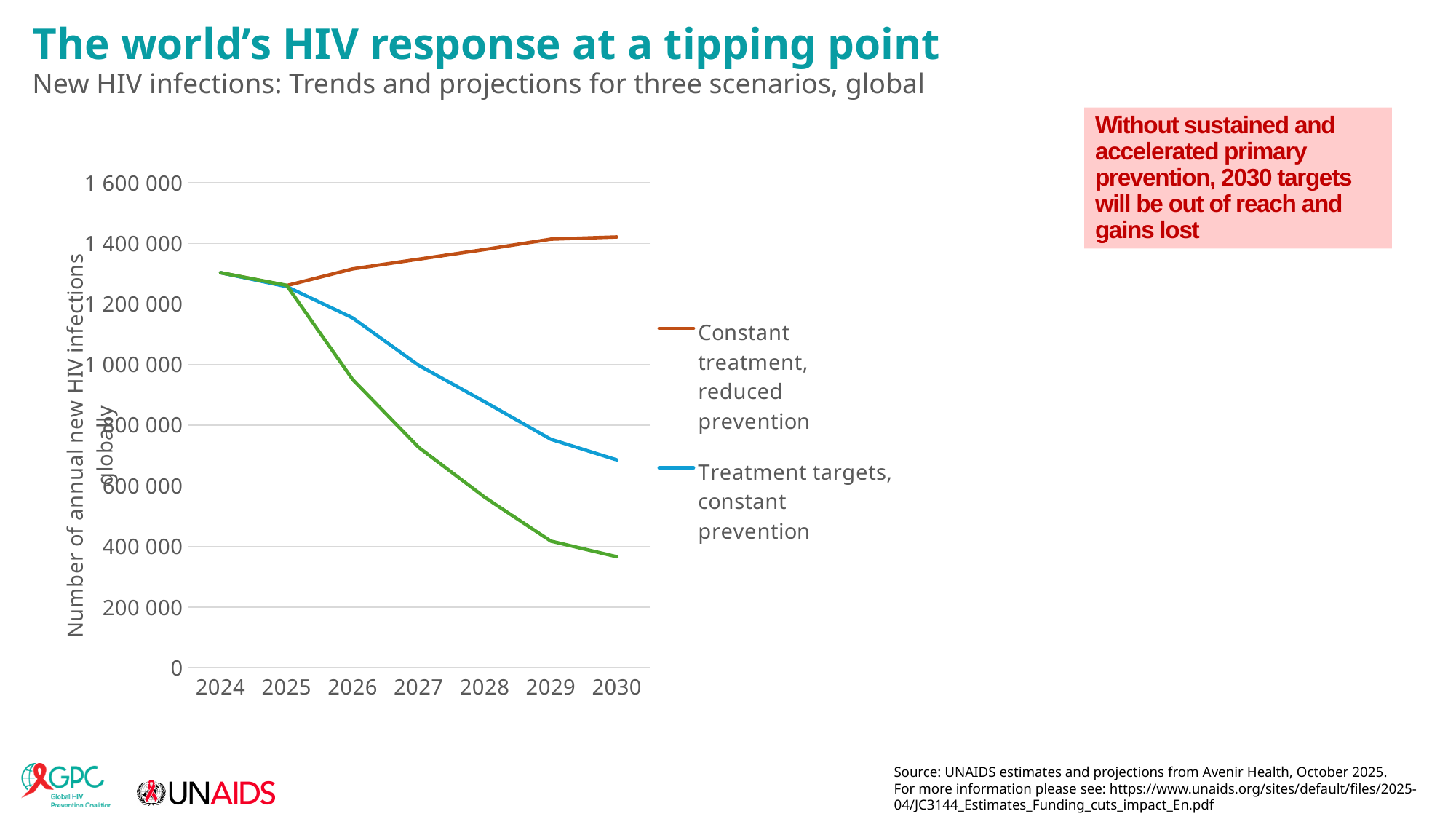
Is the value for 'Treatment targets, constant prevention' in 2030 greater or less than 800 000? less Does the 'Constant treatment, reduced prevention' line rise or fall from 2025 to 2030? rise Is the value for 'Treatment targets, constant prevention' in 2028 greater or less than 800 000? greater What is the subtitle of the chart shown on the slide? New HIV infections: Trends and projections for three scenarios, global How many years are shown along the x axis? 7 Is the value for 'Constant treatment, reduced prevention' in 2024 greater or less than 1 200 000? greater Does the 'Treatment targets, constant prevention' line rise or fall from 2024 to 2030? fall What is the label of the y axis? Number of annual new HIV infections globally In 2030, which of the two legend series has the higher value: 'Constant treatment, reduced prevention' or 'Treatment targets, constant prevention'? Constant treatment, reduced prevention What kind of chart is shown on the slide? line chart How many series does the legend list? 2